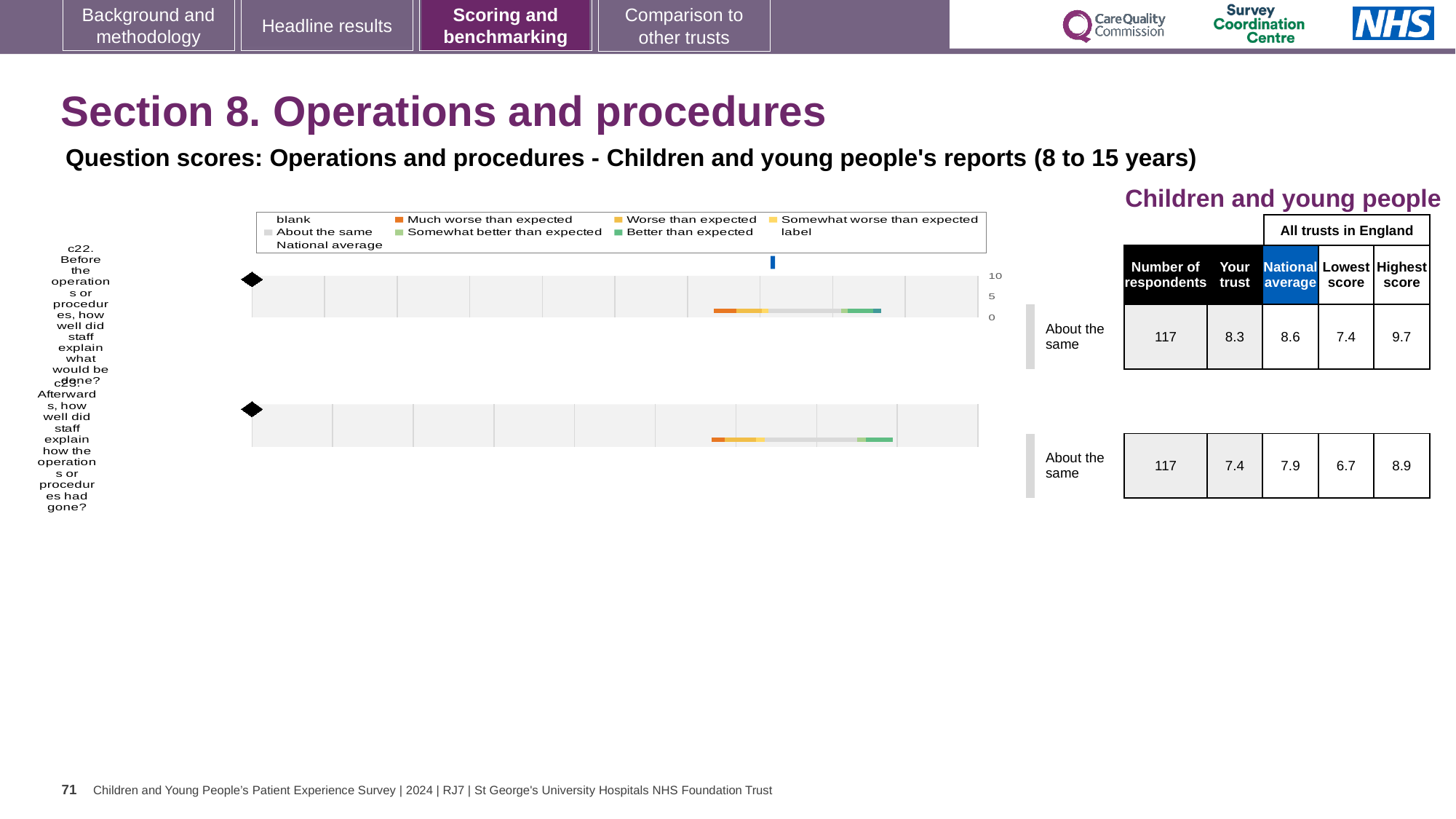
For question c22 (before the operation, how well did staff explain what would be done), what is the 'Your trust' score? 8.3 For question c22, what is the national average score? 8.6 For question c23 (afterwards, how well did staff explain how the operation had gone), what is the 'Your trust' score? 7.4 What benchmark category is shown for question c23? About the same How many questions (charts) are plotted on the slide? 2 For question c23, what is the highest score among all trusts in England? 8.9 How many respondents answered question c22? 117 For question c23, what is the difference between the national average (7.9) and the 'Your trust' score (7.4)? 0.5 What kind of chart is used to show the question scores for c22 and c23? bar chart For question c22, which is larger: the 'Your trust' score or the national average? National average Which legend entry is shown in orange? Much worse than expected For question c22, what is the difference between the highest score (9.7) and the lowest score (7.4)? 2.3